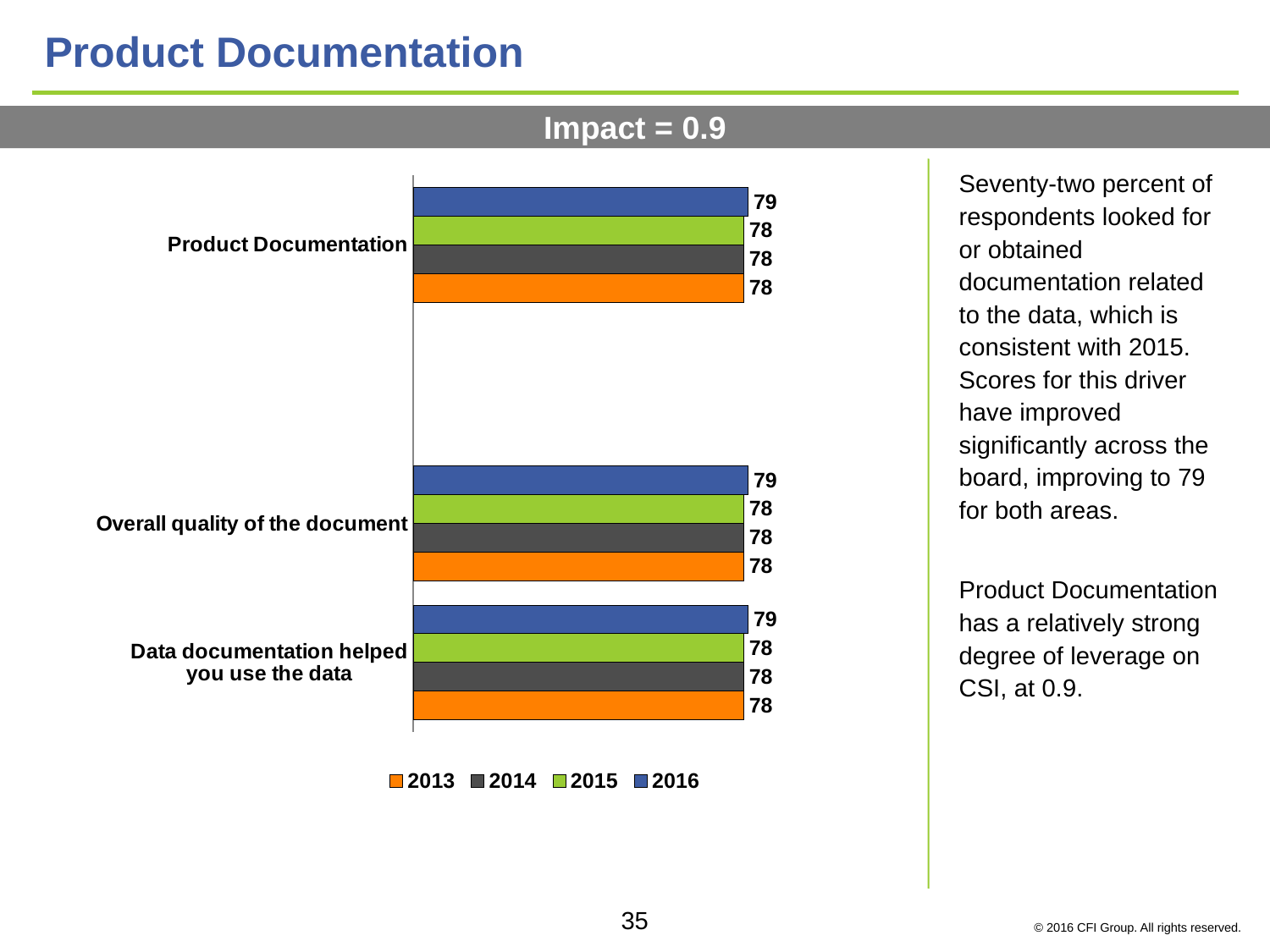
Which year is shown in orange in the legend? 2013 What is the difference between the 2016 and 2013 values for Product Documentation? 1 What kind of chart is shown on the slide? Bar chart Which year has the highest value for Data documentation helped you use the data? 2016 Is the 2016 value for Overall quality of the document larger than the 2015 value? Yes, 79 vs 78 How many categories are shown on the chart? 3 What is the 2013 value for Overall quality of the document? 78 How many series does the legend list? 4 What is the 2016 value for Product Documentation? 79 What is the 2014 value for Overall quality of the document? 78 What is the 2015 value for Data documentation helped you use the data? 78 What impact value is shown in the banner above the chart? 0.9